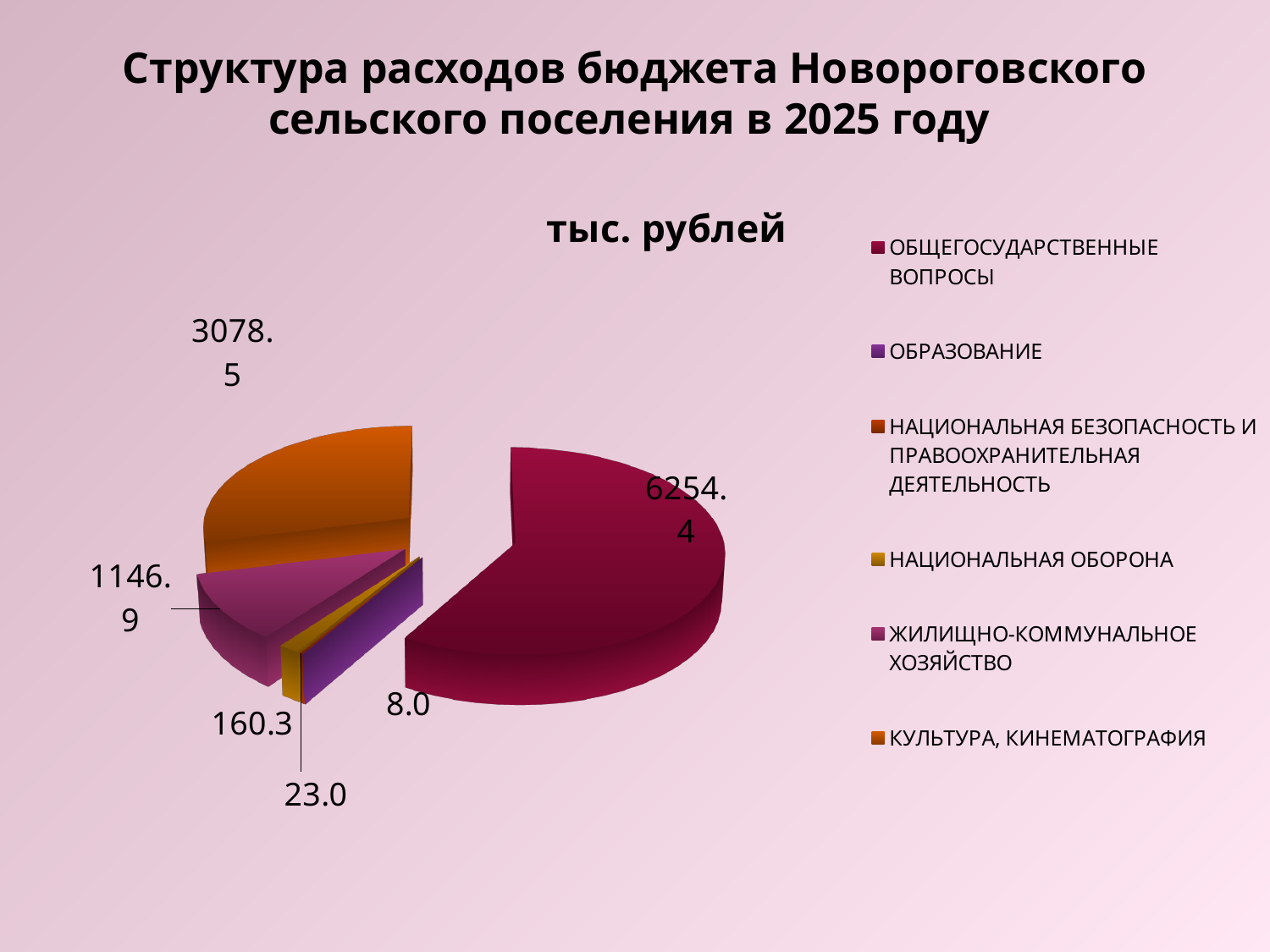
What is the smallest value labeled on the pie chart? 8.0 What is the value for КУЛЬТУРА, КИНЕМАТОГРАФИЯ in the pie chart? 3078.5 What is the value for ОБЩЕГОСУДАРСТВЕННЫЕ ВОПРОСЫ in the pie chart? 6254.4 What kind of chart is shown on the slide? pie chart What colour is the slice for ОБЩЕГОСУДАРСТВЕННЫЕ ВОПРОСЫ? dark red What is the value for ЖИЛИЩНО-КОММУНАЛЬНОЕ ХОЗЯЙСТВО in the pie chart? 1146.9 What is the difference between the values for ОБЩЕГОСУДАРСТВЕННЫЕ ВОПРОСЫ and КУЛЬТУРА, КИНЕМАТОГРАФИЯ? 3175.9 Which is larger, the value for КУЛЬТУРА, КИНЕМАТОГРАФИЯ or the value for ЖИЛИЩНО-КОММУНАЛЬНОЕ ХОЗЯЙСТВО? КУЛЬТУРА, КИНЕМАТОГРАФИЯ How many slices does the pie chart have? 6 What is the difference between the values for КУЛЬТУРА, КИНЕМАТОГРАФИЯ and ЖИЛИЩНО-КОММУНАЛЬНОЕ ХОЗЯЙСТВО? 1931.6 What is the title shown above the pie chart? тыс. рублей Which category has the largest slice in the pie chart? ОБЩЕГОСУДАРСТВЕННЫЕ ВОПРОСЫ